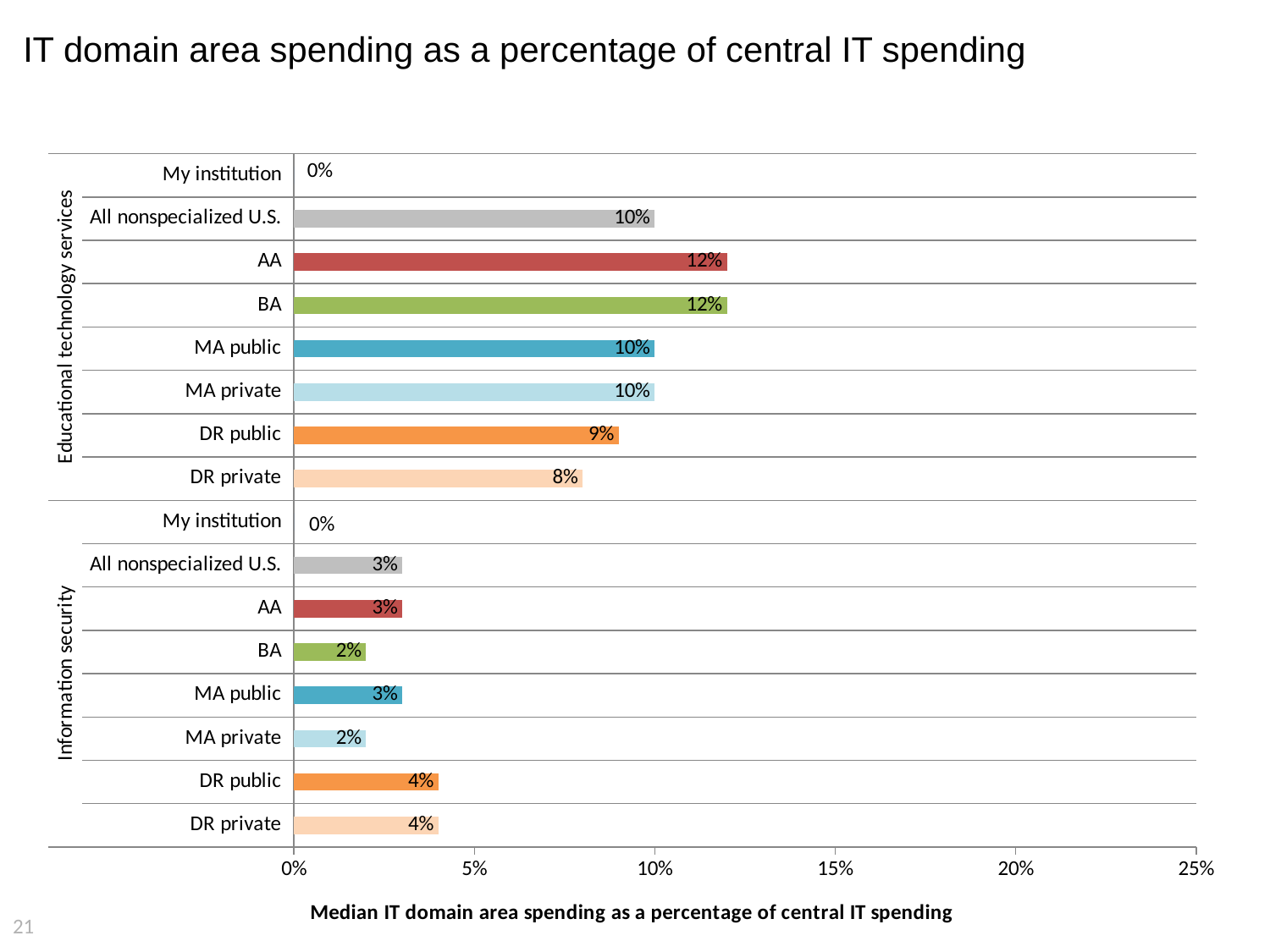
Which category has the lowest non-zero value under Educational technology services? DR private What kind of chart is shown on the slide? Bar chart What is the value for MA private under Information security? 2% Which is larger under Information security: DR public or BA? DR public What is the value shown for My institution under Educational technology services? 0% What is the value for DR public under Educational technology services? 9% Is the value for BA under Educational technology services greater or less than 10%? greater How many categories are listed under the Information security group? 8 What is the difference between the AA value under Educational technology services and the AA value under Information security? 9% What is the value for DR private under Information security? 4% What is the label on the horizontal axis of the chart? Median IT domain area spending as a percentage of central IT spending What is the value for AA under Educational technology services? 12%